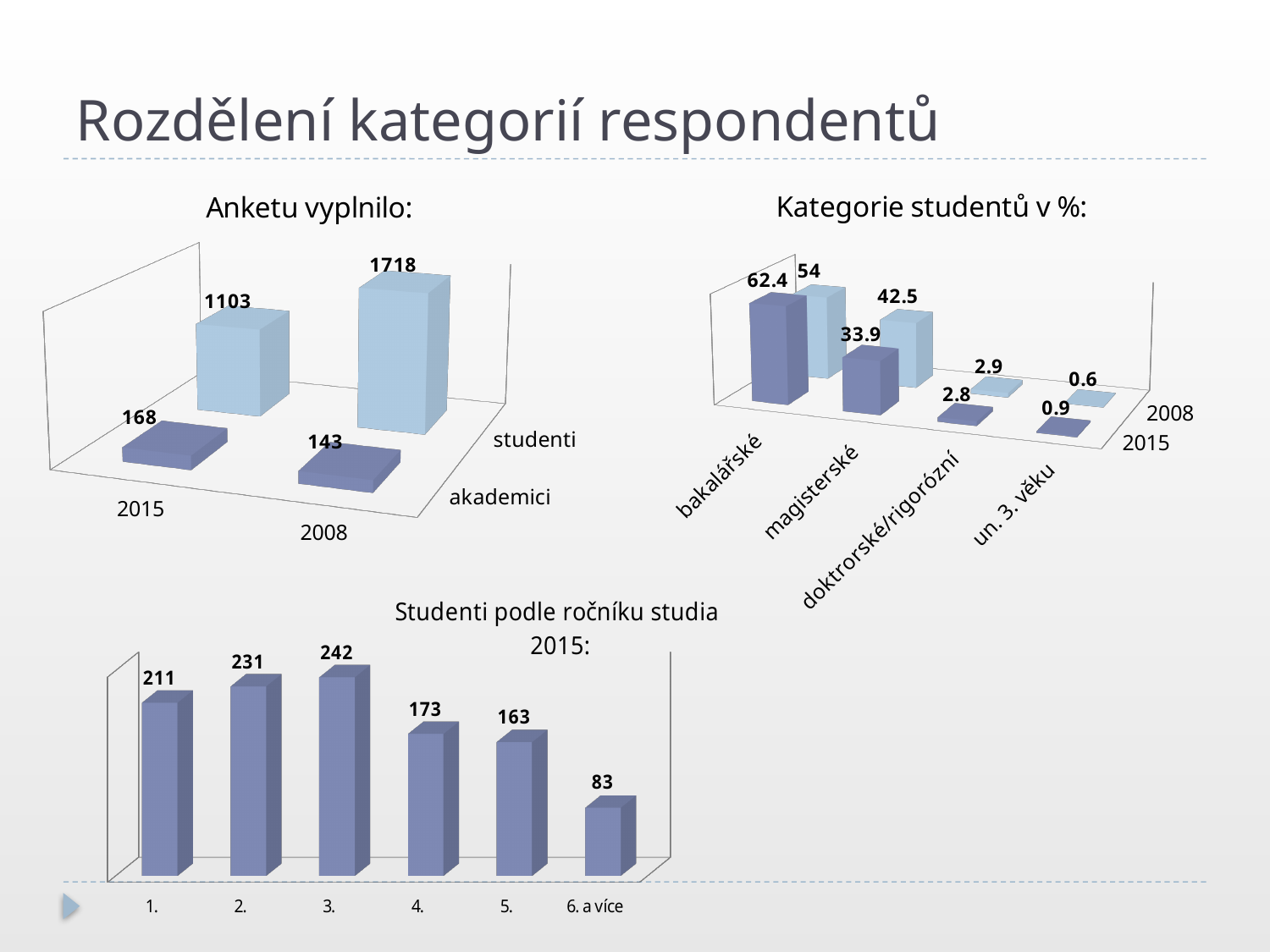
In the chart titled "Studenti podle ročníku studia 2015:", what is the difference between the values for 1. and 4.? 38 In the chart titled "Kategorie studentů v %:", how many student categories are shown on the axis? 4 In the chart titled "Kategorie studentů v %:", what is the value for bakalářské in 2015? 62.4 In the chart titled "Anketu vyplnilo:", which year had more akademici respondents, 2015 or 2008? 2015 In the chart titled "Anketu vyplnilo:", what is the difference between the number of studenti in 2008 and in 2015? 615 In the chart titled "Studenti podle ročníku studia 2015:", which year of study has the highest number of students? 3. In the chart titled "Kategorie studentů v %:", which category has the lowest value in 2008? un. 3. věku In the chart titled "Kategorie studentů v %:", what is the value for magisterské in 2008? 42.5 In the chart titled "Anketu vyplnilo:", how many studenti responded in 2008? 1718 In the chart titled "Anketu vyplnilo:", how many akademici responded in 2015? 168 In the chart titled "Studenti podle ročníku studia 2015:", what is the value for "6. a více"? 83 What type of chart is "Studenti podle ročníku studia 2015:"? Bar chart